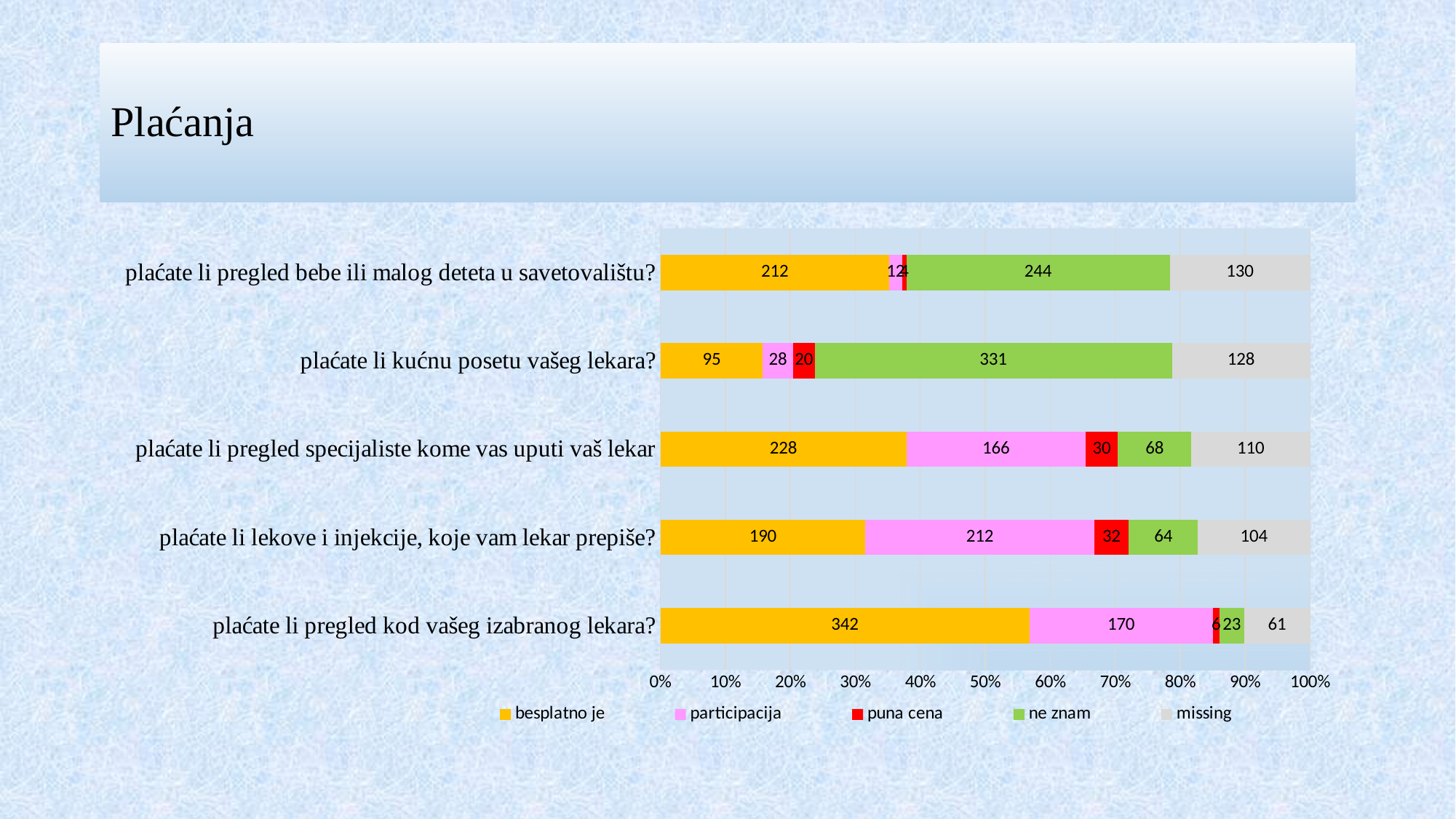
What is the difference between the 'participacija' values for 'plaćate li lekove i injekcije, koje vam lekar prepiše?' and 'plaćate li pregled specijaliste kome vas uputi vaš lekar'? 46 What is the total of all segments in the bar for 'plaćate li kućnu posetu vašeg lekara?'? 602 How many series does the legend list? 5 Which has the larger 'ne znam' value: 'plaćate li pregled bebe ili malog deteta u savetovalištu?' or 'plaćate li kućnu posetu vašeg lekara?'? plaćate li kućnu posetu vašeg lekara? Which question has the lowest 'missing' value? plaćate li pregled kod vašeg izabranog lekara? Which question has the highest 'besplatno je' value? plaćate li pregled kod vašeg izabranog lekara? What is the value of 'ne znam' for 'plaćate li kućnu posetu vašeg lekara?'? 331 What colour represents 'puna cena' in the legend? Red What is the 'missing' value for 'plaćate li pregled specijaliste kome vas uputi vaš lekar'? 110 How many questions (categories) are shown on the chart? 5 What kind of chart is shown on the slide? Stacked bar chart What is the value of 'besplatno je' for 'plaćate li pregled kod vašeg izabranog lekara?'? 342